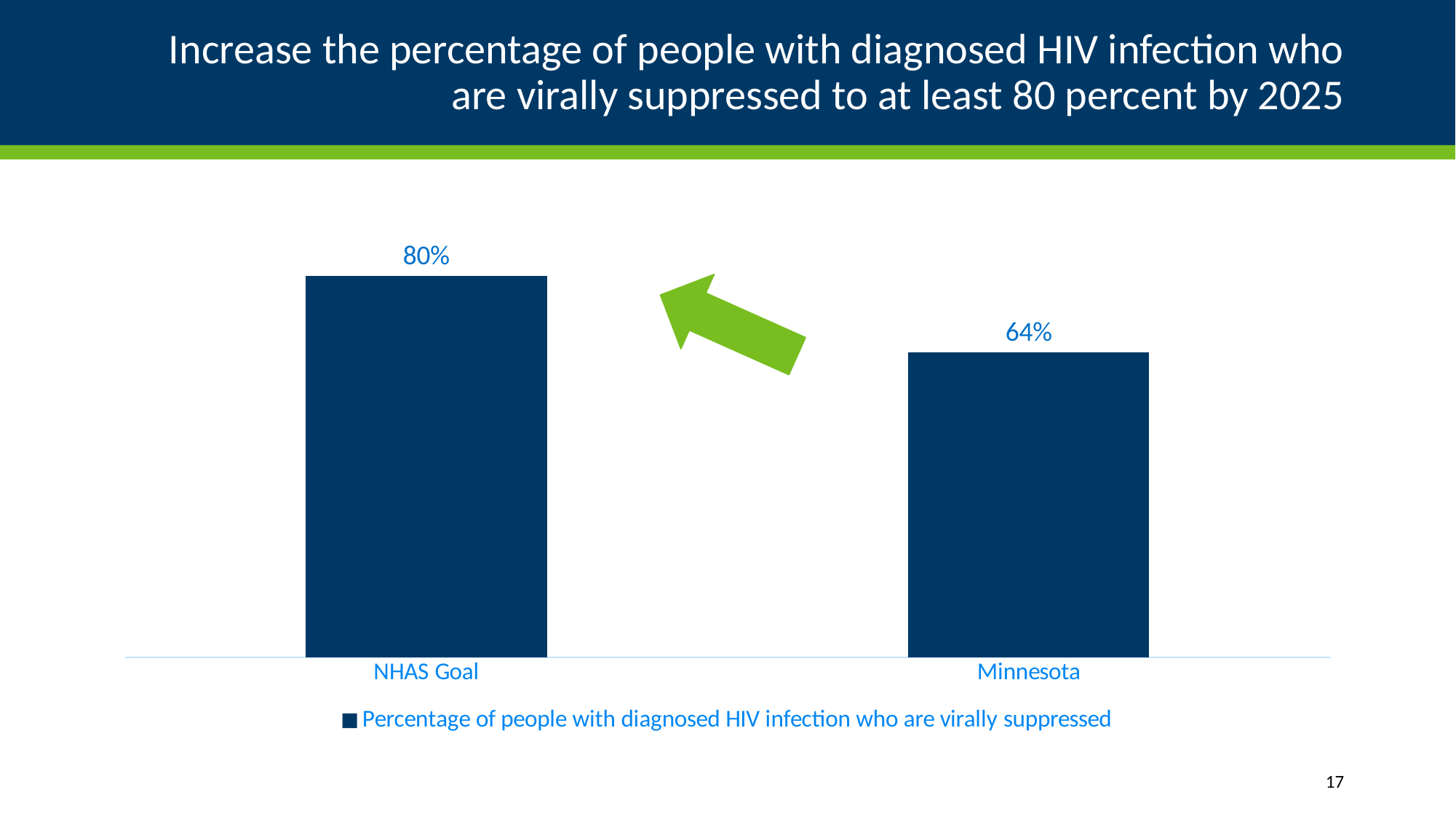
How many categories are shown on the chart? 2 What is the value for NHAS Goal? 80% Which is larger, the value for NHAS Goal or the value for Minnesota? NHAS Goal What is the value for Minnesota? 64% What is the difference between the NHAS Goal value and the Minnesota value? 16% What is the legend entry for the series shown? Percentage of people with diagnosed HIV infection who are virally suppressed Which category has the lowest value? Minnesota What kind of chart is shown on the slide? Bar chart What colour are the bars in the chart? Dark blue How many series does the legend list? 1 Which category has the highest value? NHAS Goal